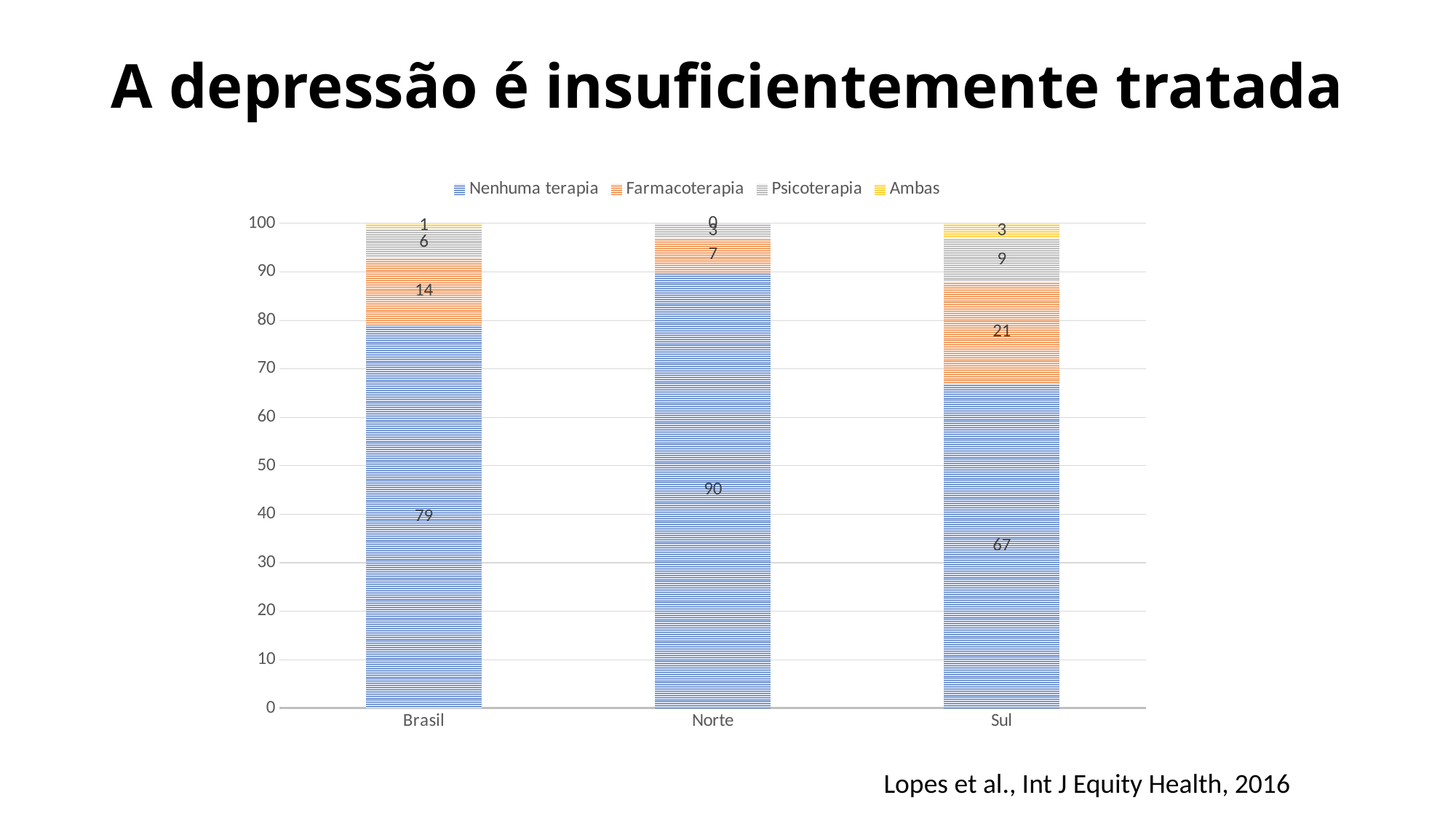
What is the total of the stacked bar for Sul? 100 What is the value of Nenhuma terapia for Brasil? 79 How many series does the legend list? 4 What is the value of Ambas for Sul? 3 Which is larger, the Psicoterapia value for Sul or for Brasil? Sul What is the value of Psicoterapia for Norte? 3 Which category has the lowest value for Farmacoterapia? Norte Which category has the highest value for Nenhuma terapia? Norte What is the value of Farmacoterapia for Sul? 21 How many categories are shown on the x axis? 3 What is the difference between the Nenhuma terapia values for Norte and Sul? 23 What kind of chart is shown on the slide? Stacked bar chart